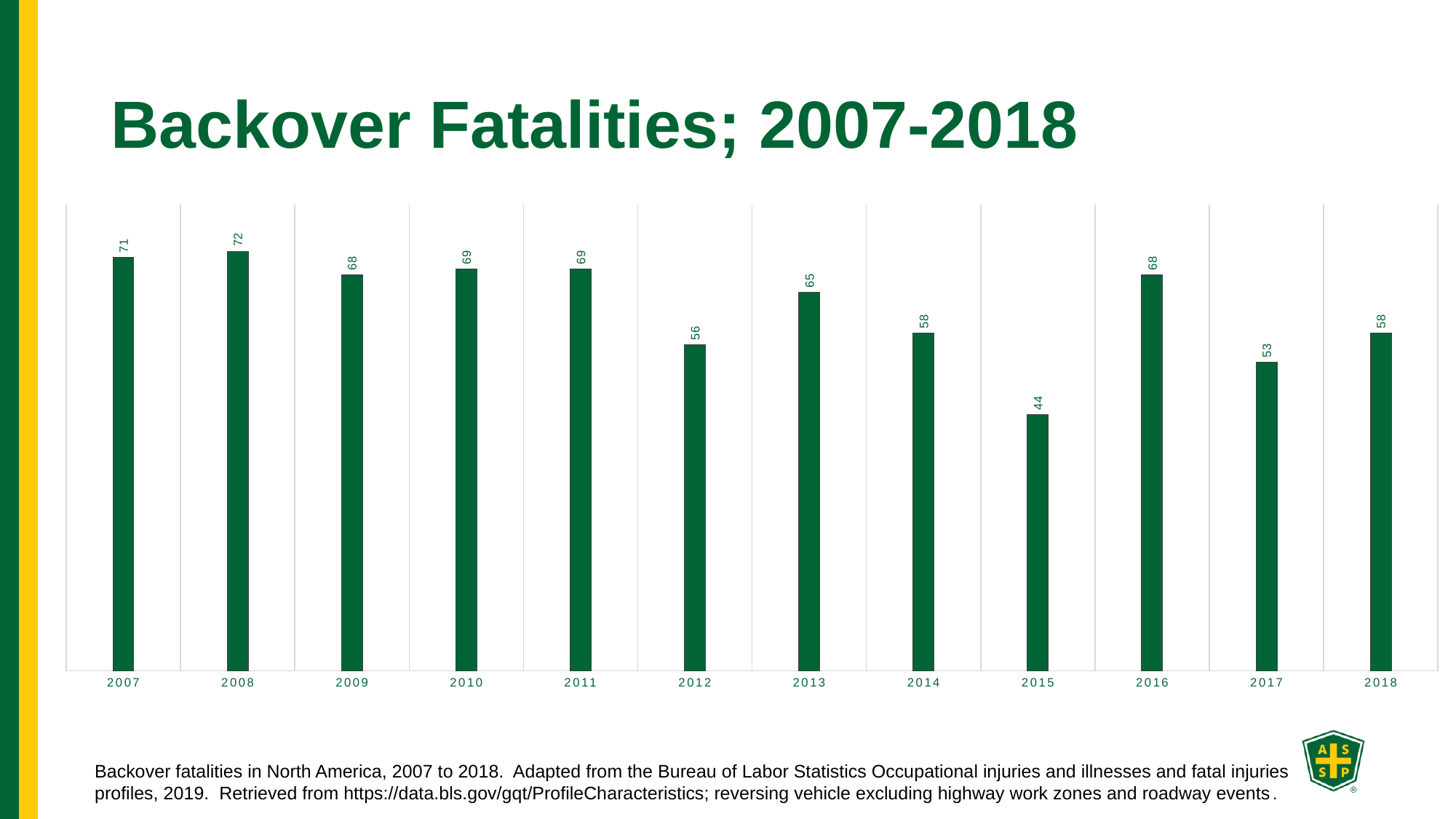
What kind of chart is shown on the slide? Bar chart Do the values rise or fall from 2016 to 2017? Fall What is the value for 2015? 44 Which is larger, the value for 2012 or the value for 2016? 2016 What is the title of the slide? Backover Fatalities; 2007-2018 What is the difference between the values for 2013 and 2014? 7 How many years are shown on the x axis? 12 What is the value for 2008? 72 What is the value for 2017? 53 Which year has the lowest value? 2015 What is the difference between the values for 2008 and 2015? 28 Which year has the highest value? 2008